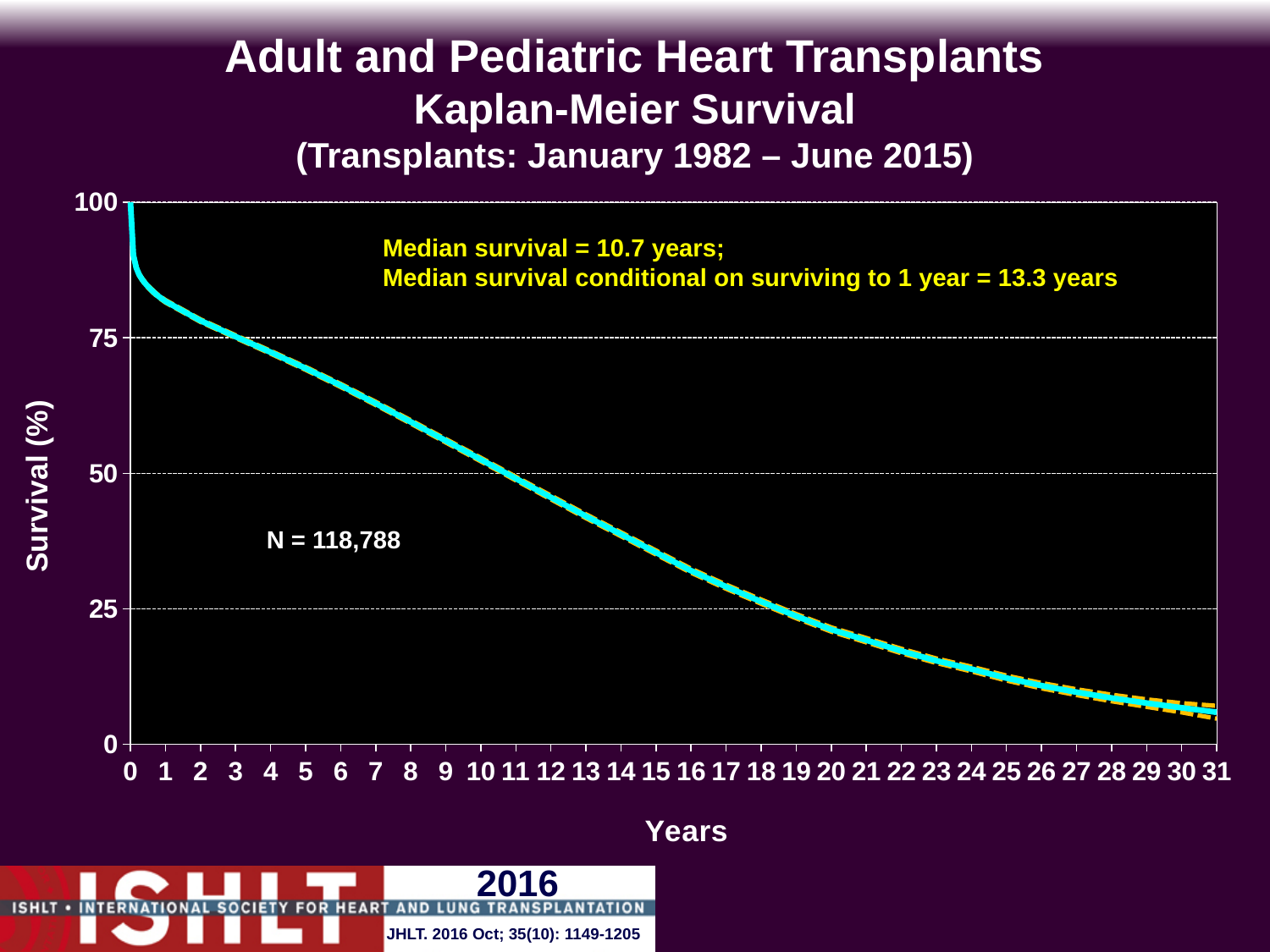
Is the survival at 1 year greater or less than 75%? greater What is the median survival conditional on surviving to 1 year, as stated on the chart? 13.3 years Is the survival at 20 years greater or less than 25%? less What is the value of N shown on the chart? 118,788 Is the survival at 5 years greater or less than 50%? greater What is the median survival stated on the chart? 10.7 years Does survival rise or fall as the number of years since transplant increases? Fall What is the label of the y-axis? Survival (%) What transplant date range is given in the chart title? January 1982 – June 2015 What kind of chart is shown on the slide? Line chart